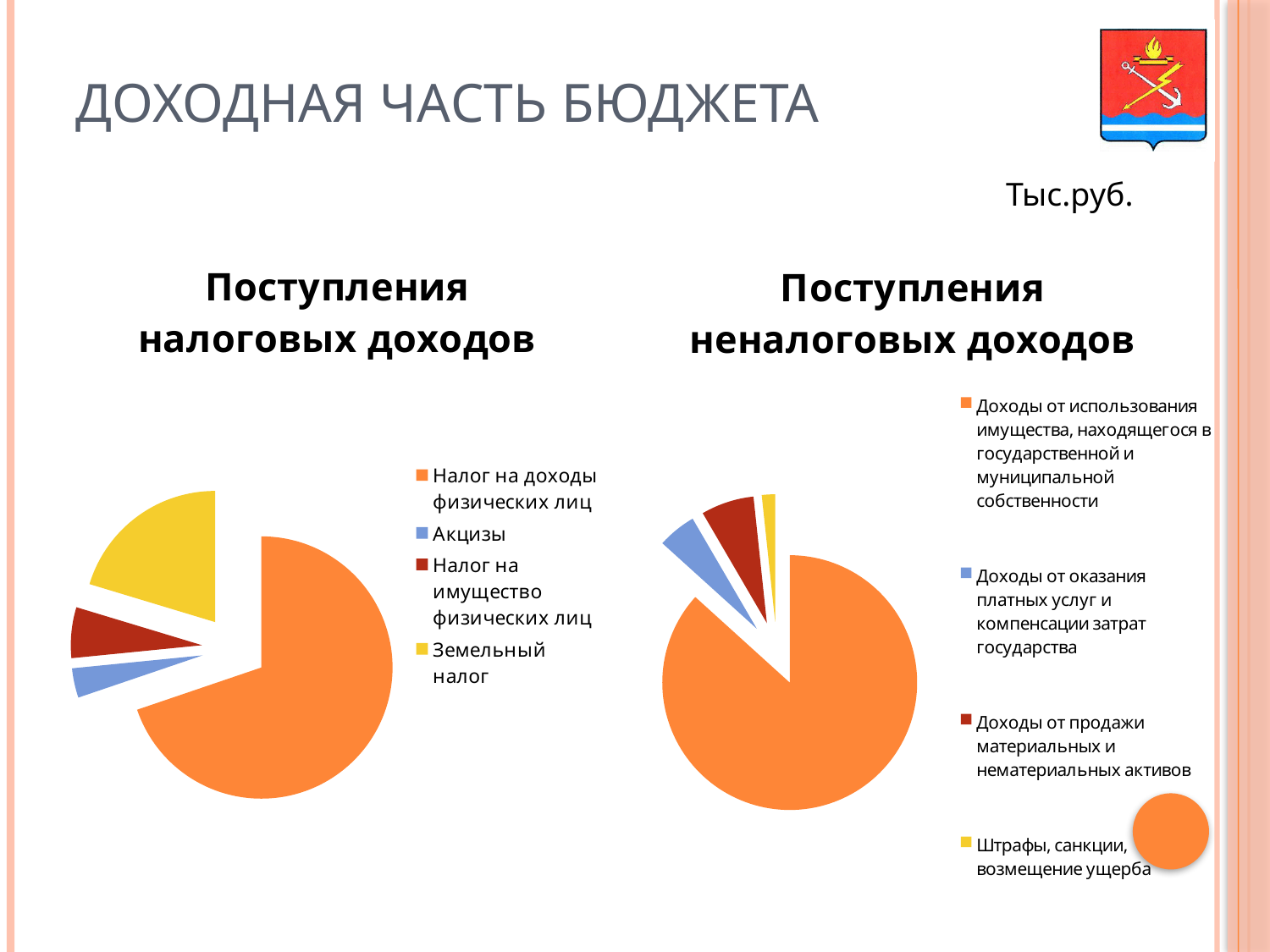
In the left chart "Поступления налоговых доходов", what colour is the slice for Земельный налог? Yellow In the left chart "Поступления налоговых доходов", which is larger: Акцизы or Налог на имущество физических лиц? Налог на имущество физических лиц In the left chart "Поступления налоговых доходов", which category has the smallest slice? Акцизы What kind of chart is the left chart titled "Поступления налоговых доходов"? Pie chart In the left chart "Поступления налоговых доходов", which category has the largest slice? Налог на доходы физических лиц In the left chart "Поступления налоговых доходов", how many slices does the pie have? 4 In the right chart "Поступления неналоговых доходов", which category has the largest slice? Доходы от использования имущества, находящегося в государственной и муниципальной собственности In the left chart "Поступления налоговых доходов", which is larger: Земельный налог or Налог на имущество физических лиц? Земельный налог In the right chart "Поступления неналоговых доходов", which category has the smallest slice? Штрафы, санкции, возмещение ущерба What unit is stated on the slide for the values in the charts? Тыс.руб. What kind of chart is the right chart titled "Поступления неналоговых доходов"? Pie chart In the right chart "Поступления неналоговых доходов", how many categories does the legend list? 4